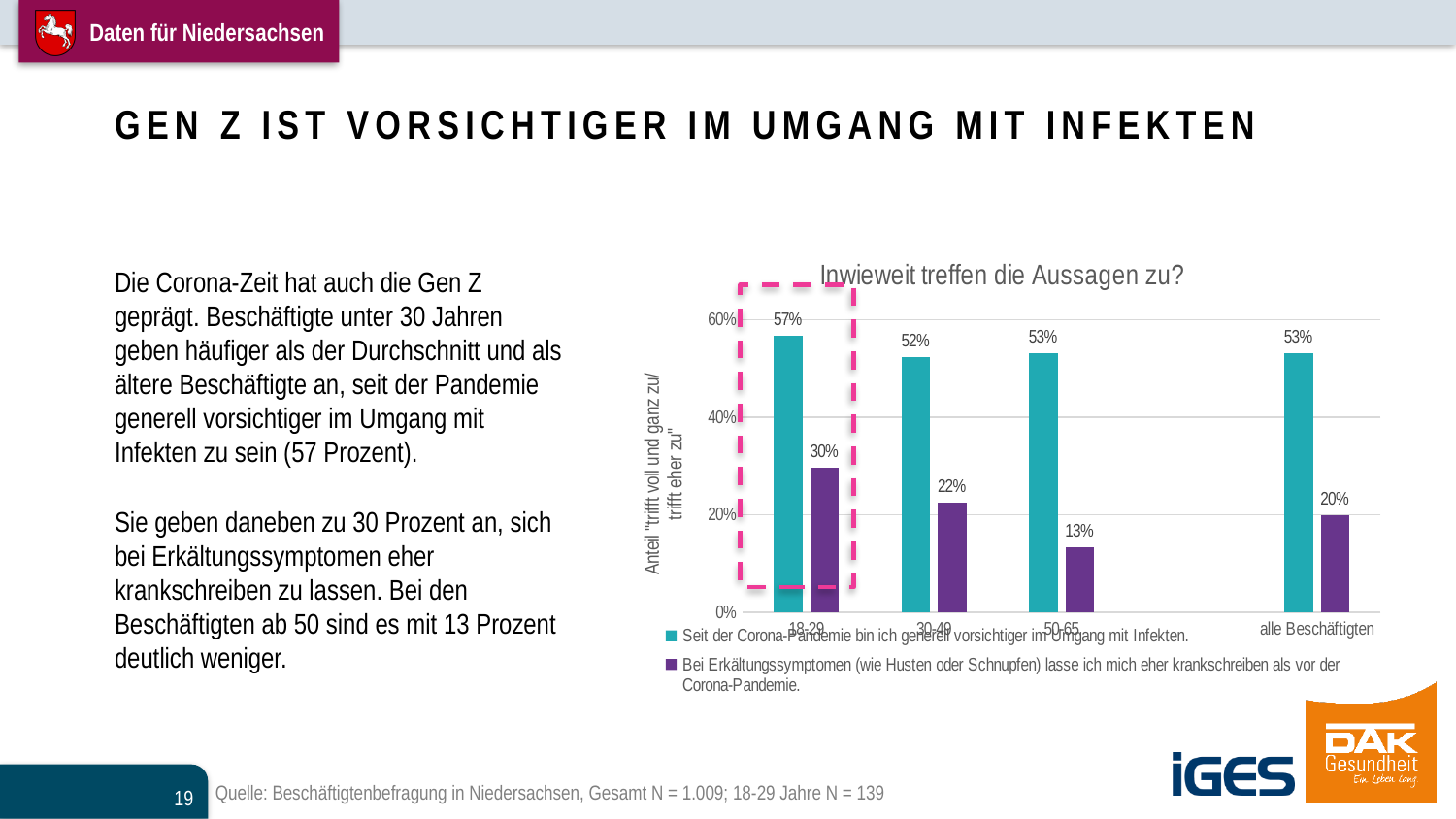
What kind of chart is shown on the slide? Bar chart What is the value for the 30-49 group for the series about taking sick leave more readily ("eher krankschreiben")? 22% What is the value for the 18-29 group for the series "Seit der Corona-Pandemie bin ich generell vorsichtiger im Umgang mit Infekten"? 57% For the 18-29 group, which series has the larger value: "vorsichtiger im Umgang mit Infekten" or "eher krankschreiben"? vorsichtiger im Umgang mit Infekten Which age group has the highest value for the series "vorsichtiger im Umgang mit Infekten"? 18-29 What is the value for "alle Beschäftigten" for the series about being more cautious with infections ("vorsichtiger im Umgang mit Infekten")? 53% How many series does the chart's legend list? 2 What is the title of the chart? Inwieweit treffen die Aussagen zu? What is the value for the 50-65 group for the series "Bei Erkältungssymptomen ... lasse ich mich eher krankschreiben als vor der Corona-Pandemie"? 13% What is the difference between the 18-29 group and the 50-65 group for the series "eher krankschreiben"? 17 percentage points Which category has the lowest value for the series "eher krankschreiben"? 50-65 How many categories are shown on the x axis of the chart? 4